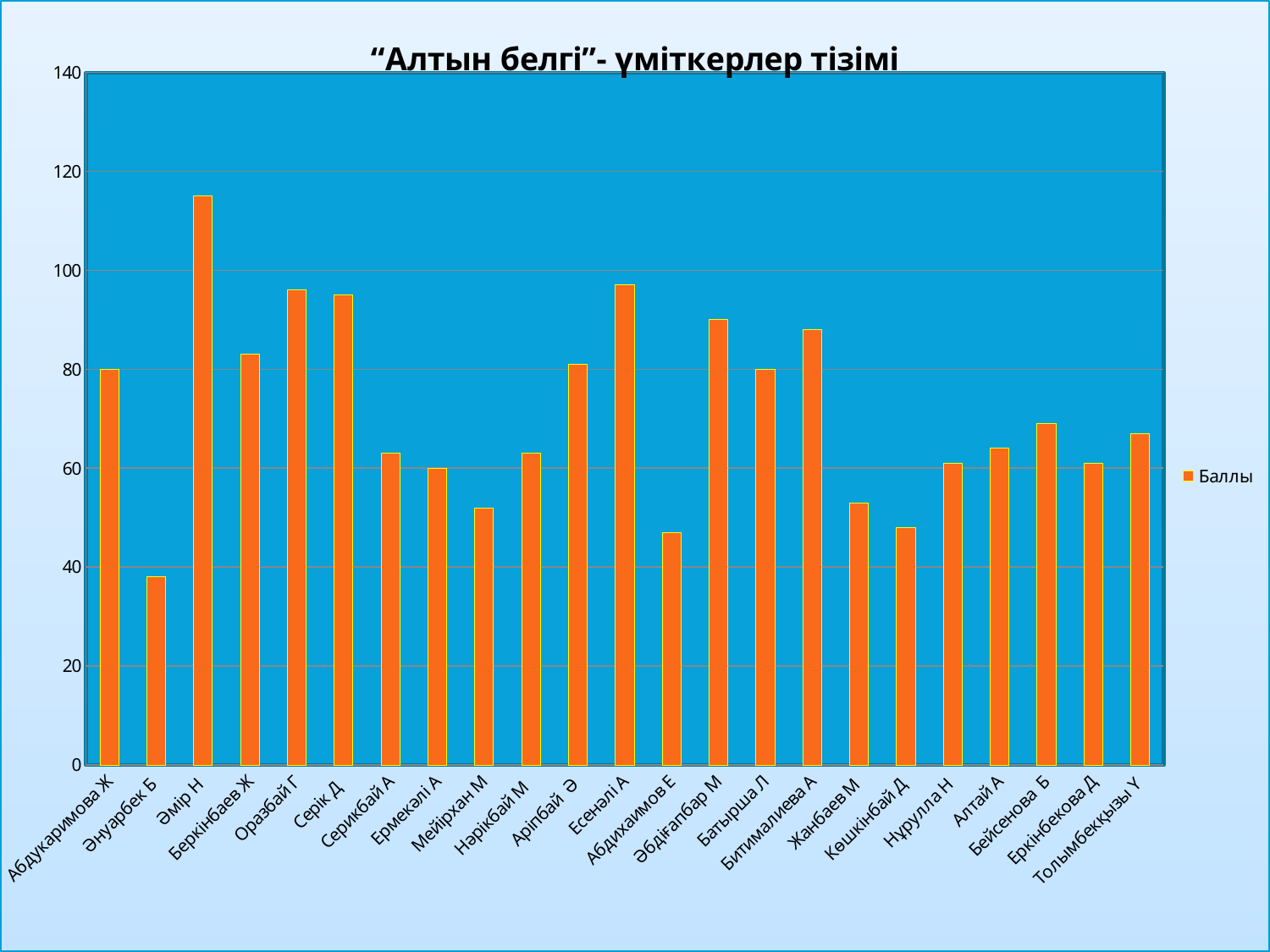
How many candidates (categories) are shown on the x axis? 23 What kind of chart is shown on the slide? bar chart Is the value for Абдихаимов Е greater or less than 60? less Which candidate has the lowest value? Әнуарбек Б Is the value for Есенәлі А greater or less than 80? greater How many series does the legend list? 1 What is the name of the series shown in the legend? Баллы Which candidate has the highest value? Әмір Н Is the value for Әмір Н greater or less than 100? greater What is the title of the chart? “Алтын белгі”- үміткерлер тізімі Which is larger, the value for Есенәлі А or the value for Абдихаимов Е? Есенәлі А